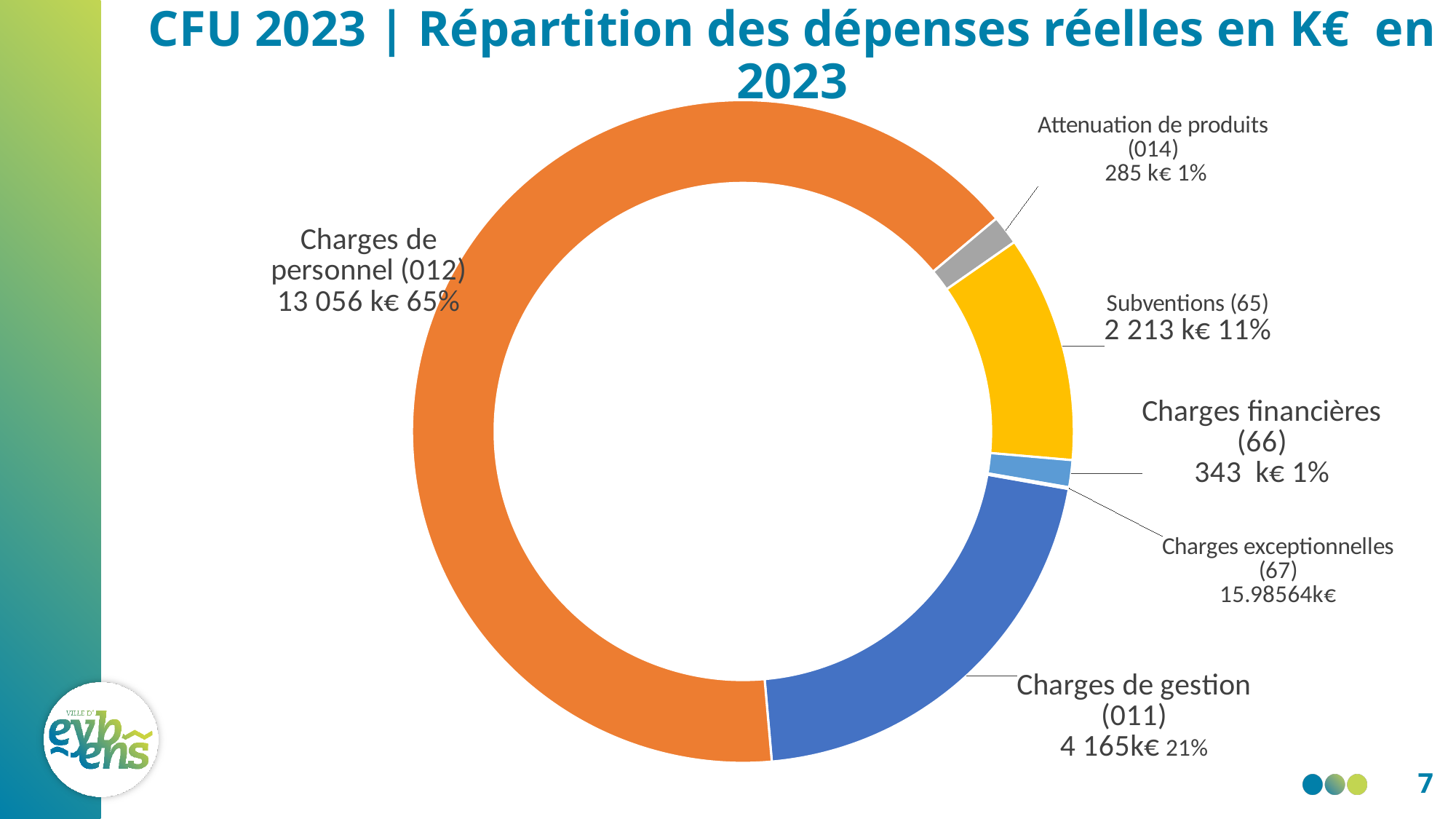
What is the value for Charges de personnel (012)? 13 056 k€ What is the value for Charges exceptionnelles (67)? 15.98564k€ What is the difference between Charges financières (66) and Attenuation de produits (014)? 58 k€ Which category has the smallest value? Charges exceptionnelles (67) What kind of chart is shown on the slide? doughnut chart What is the value for Subventions (65)? 2 213 k€ What percentage share does Charges de gestion (011) have? 21% What colour is the Subventions (65) slice? yellow Which category has the largest share of the chart? Charges de personnel (012) How many categories does the chart show? 6 What is the difference between Charges de personnel (012) and Charges de gestion (011)? 8 891 k€ Which is larger, Subventions (65) or Charges de gestion (011)? Charges de gestion (011)